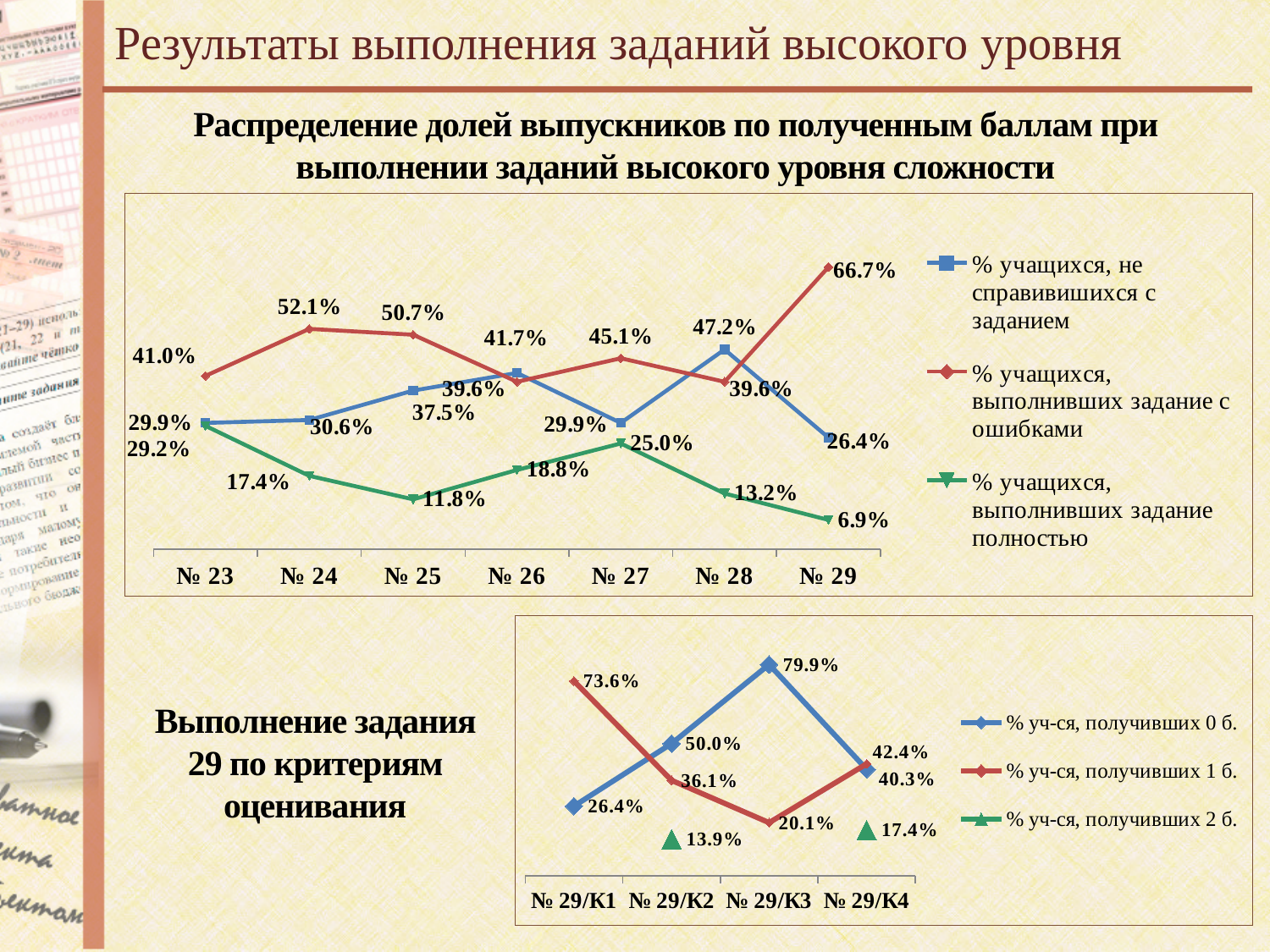
In the bottom chart, what percentage of students received 2 points on criterion № 29/К2? 13.9% What type of chart is the bottom chart? line chart In the top chart, what percentage of students completed task № 24 with errors? 52.1% In the top chart, what percentage of students completed task № 27 fully? 25.0% In the top chart, for which task is the share of students who completed the task fully the lowest? № 29 How many tasks are shown on the x axis of the top chart? 7 How many series does the legend of the top chart list? 3 In the bottom chart, what percentage of students received 0 points on criterion № 29/К3? 79.9% In the top chart, which is larger for task № 28: the share of students who did not cope with the task or the share who completed it with errors? the share who did not cope with the task (47.2%) In the top chart, for which task is the share of students who completed the task with errors the highest? № 29 In the top chart, what is the difference between the share of students who completed task № 29 with errors and the share who did not cope with it? 40.3% In the top chart, what percentage of students did not cope with task № 29? 26.4%